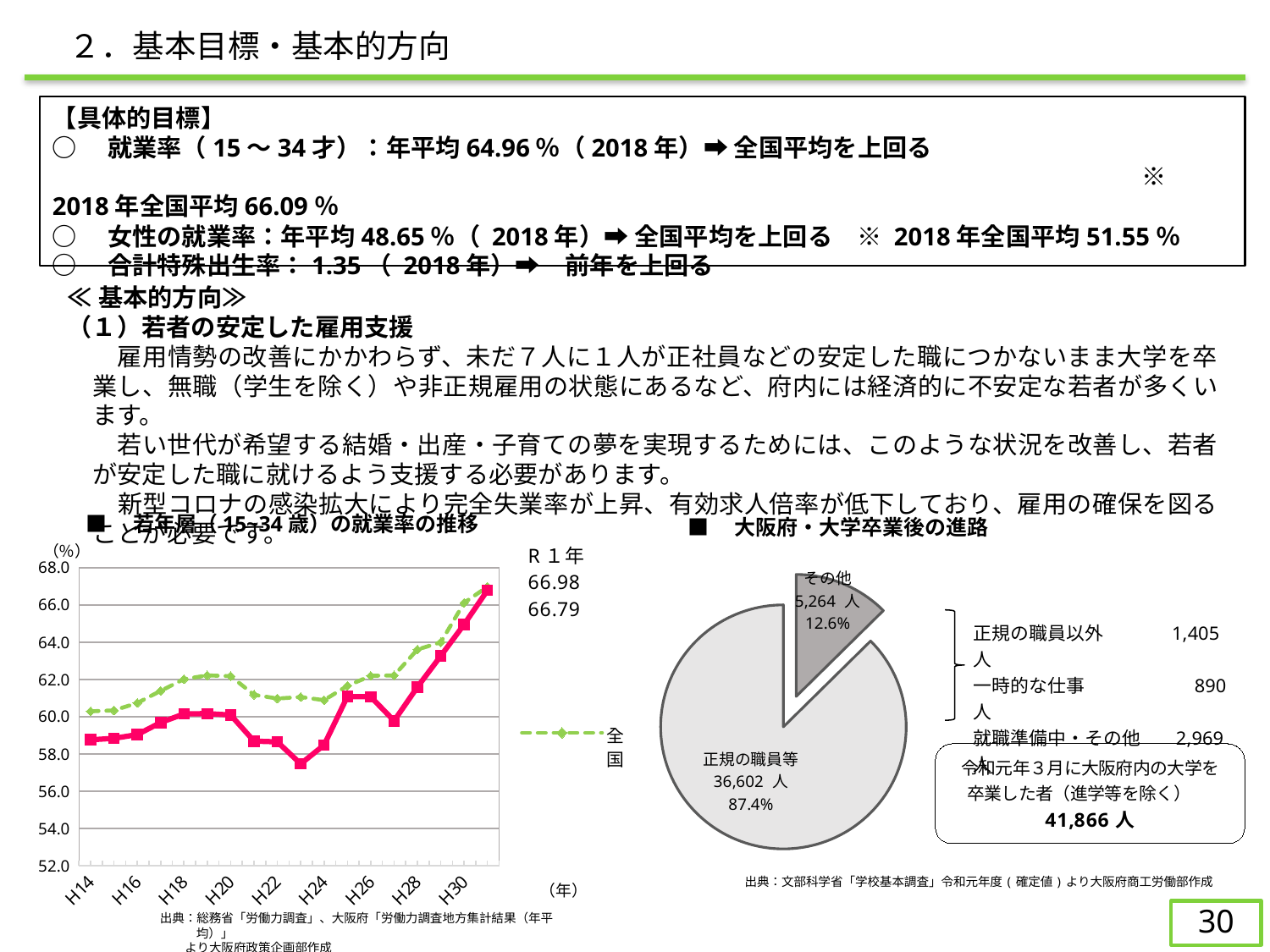
In the pie chart 大阪府・大学卒業後の進路, how many people are listed under 正規の職員以外? 1,405 人 In the line chart 若年層（15-34歳）の就業率の推移, in which year does the solid pink line reach its lowest point? H23 In the pie chart 大阪府・大学卒業後の進路, how many people are listed under 一時的な仕事? 890 人 In the pie chart 大阪府・大学卒業後の進路, how many people are in the 正規の職員等 slice? 36,602 人 In the pie chart 大阪府・大学卒業後の進路, what is the total number of graduates shown in the box? 41,866 人 In the pie chart 大阪府・大学卒業後の進路, how many more people are in 正規の職員等 than in その他? 31,338 人 In the pie chart 大阪府・大学卒業後の進路, what share of the pie is the その他 slice? 12.6% What kind of chart is the chart titled 若年層（15-34歳）の就業率の推移? line chart What kind of chart is the chart titled 大阪府・大学卒業後の進路? pie chart In the line chart 若年層（15-34歳）の就業率の推移, is the value of the solid pink line at H23 greater or less than 58.0? less In the line chart 若年層（15-34歳）の就業率の推移, what two values are printed for R1年? 66.98 and 66.79 In the pie chart 大阪府・大学卒業後の進路, which slice is the largest? 正規の職員等